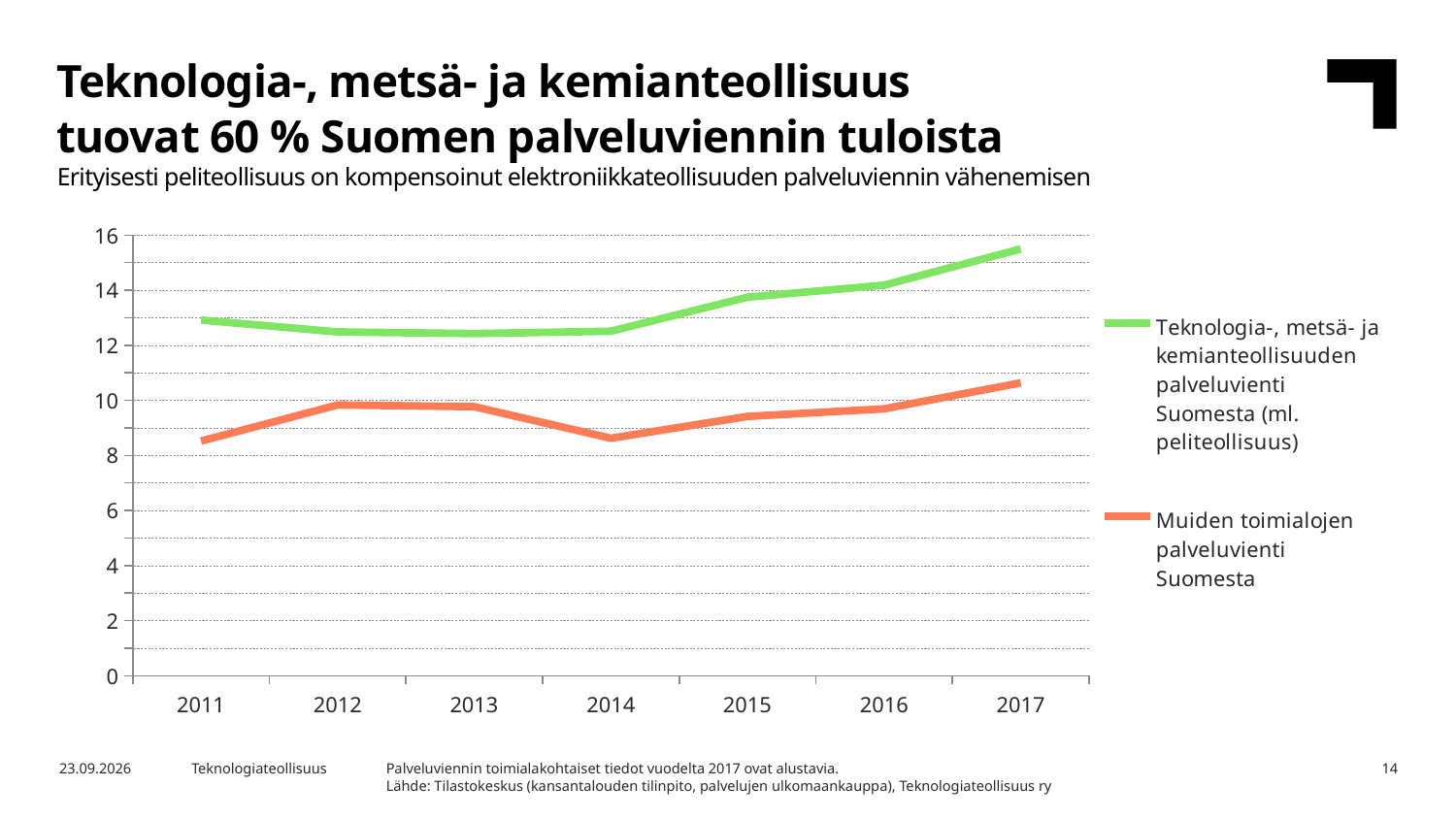
How many years are plotted along the x axis? 7 Is the value for Teknologia-, metsä- ja kemianteollisuuden palveluvienti Suomesta in 2013 greater or less than 14? less How many series does the legend list? 2 In which year is the value for Muiden toimialojen palveluvienti Suomesta highest? 2017 In which year is the value for Teknologia-, metsä- ja kemianteollisuuden palveluvienti Suomesta highest? 2017 What colour is the line for Muiden toimialojen palveluvienti Suomesta? Orange Does the value for Teknologia-, metsä- ja kemianteollisuuden palveluvienti Suomesta rise or fall from 2014 to 2017? rise Is the value for Teknologia-, metsä- ja kemianteollisuuden palveluvienti Suomesta in 2017 greater or less than 14? greater Is the value for Muiden toimialojen palveluvienti Suomesta in 2017 greater or less than 10? greater Which series has the larger value in 2015: Teknologia-, metsä- ja kemianteollisuuden palveluvienti Suomesta or Muiden toimialojen palveluvienti Suomesta? Teknologia-, metsä- ja kemianteollisuuden palveluvienti Suomesta What kind of chart is shown on the slide? Line chart